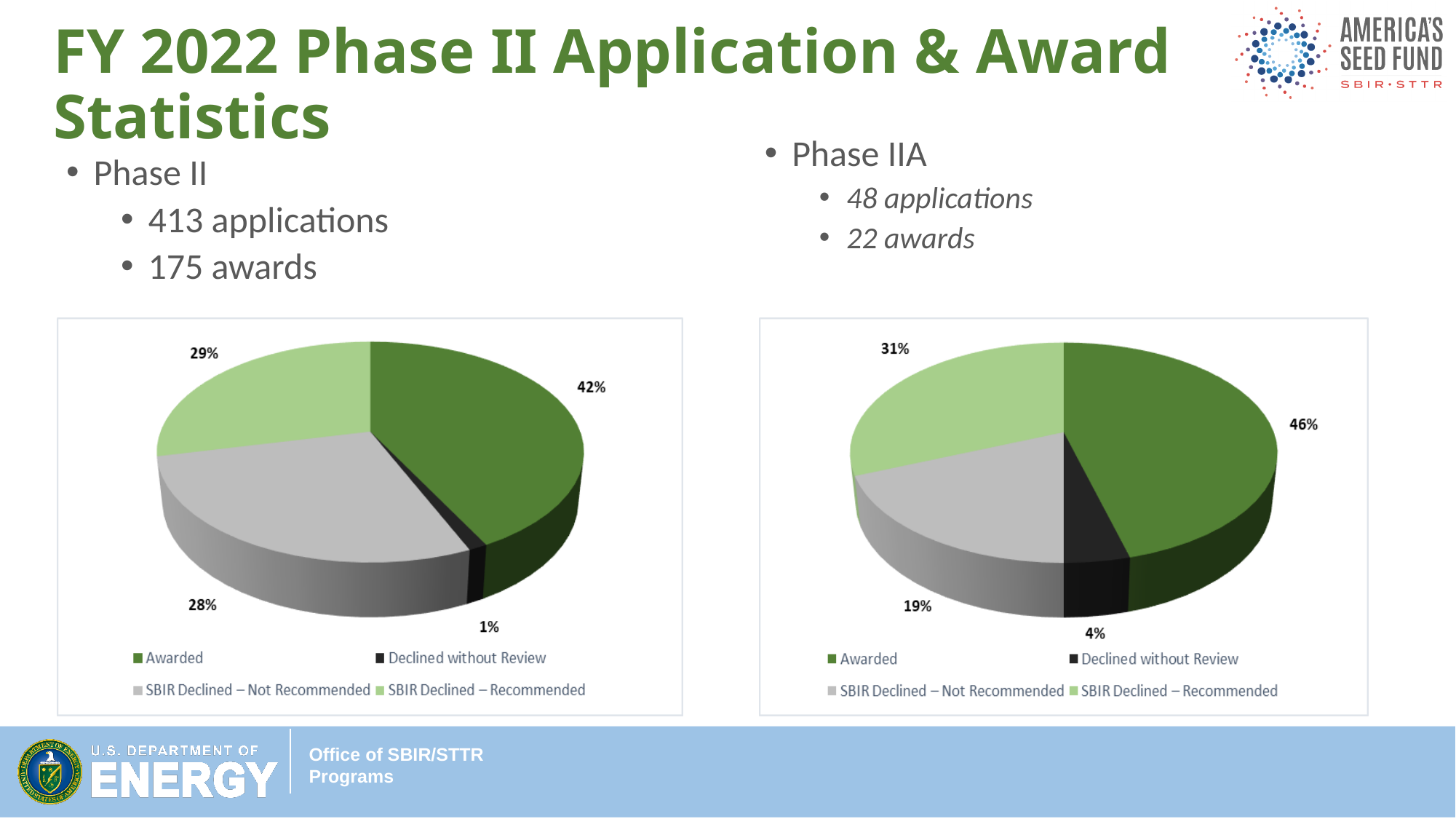
In the left pie chart, what percentage is labelled for Declined without Review? 1% What type of chart is shown on the left side of the slide? Pie chart How many categories does the legend of the right pie chart list? 4 In the left pie chart, what is the difference between the SBIR Declined – Recommended share and the SBIR Declined – Not Recommended share? 1% In the right pie chart, what percentage is labelled for the Awarded slice? 46% In the right pie chart, which category has the smallest share? Declined without Review In the left pie chart, which category has the smallest share? Declined without Review In the left pie chart, which category has the largest share? Awarded Which is larger: the Declined without Review share in the left pie chart or in the right pie chart? Right pie chart In the left pie chart, what percentage is labelled for the Awarded slice? 42% In the right pie chart, what percentage is labelled for SBIR Declined – Not Recommended? 19% In the right pie chart, what is the difference between the Awarded share and the SBIR Declined – Recommended share? 15%